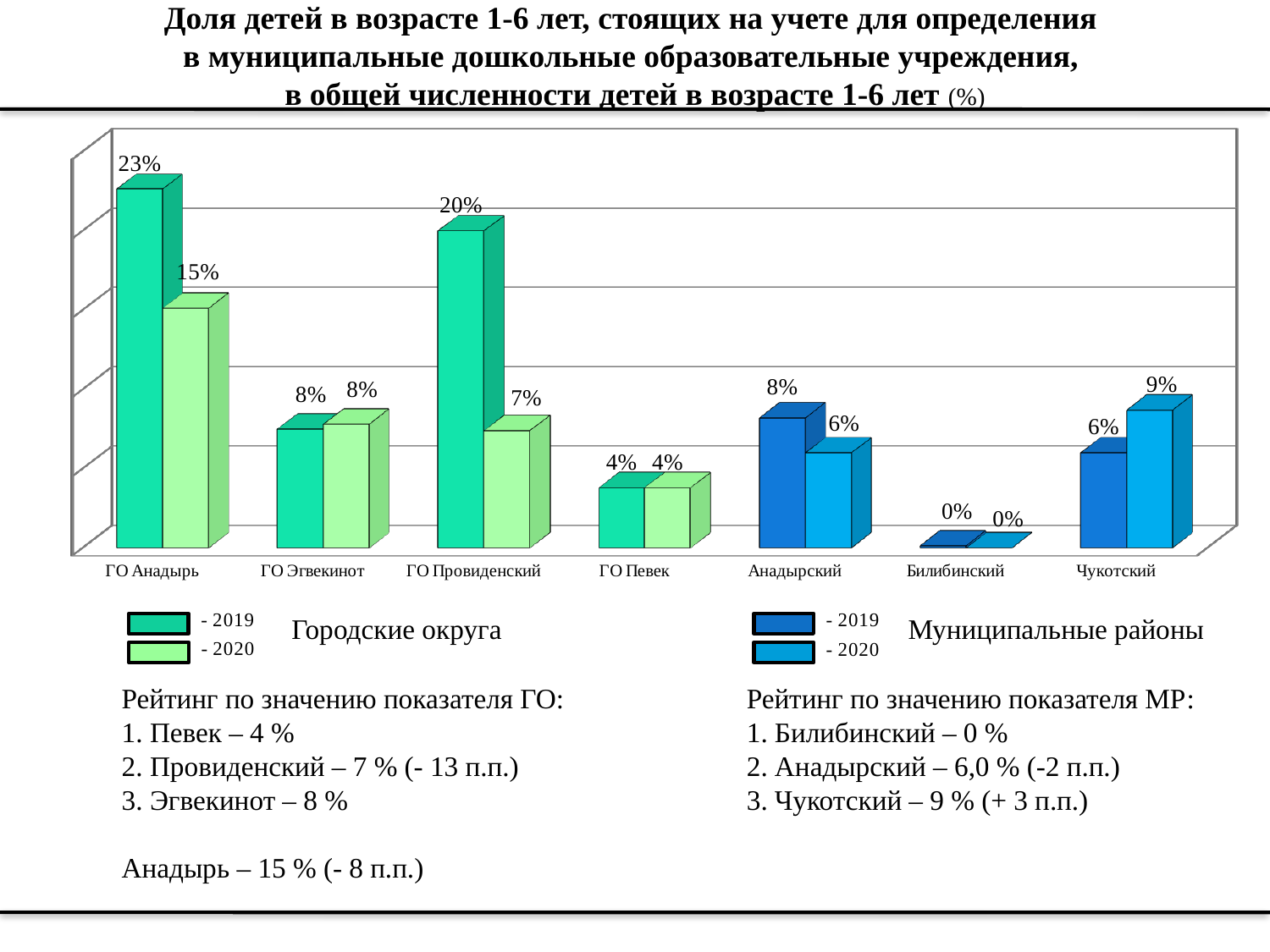
Which category has the lowest 2020 value? Билибинский What is the difference between the 2019 and 2020 values for ГО Анадырь? 8% What is the difference between the 2019 and 2020 values for ГО Провиденский? 13% What is the 2020 value for Чукотский? 9% Which category has the highest 2019 value? ГО Анадырь Did the value for Чукотский rise or fall from 2019 to 2020? rise How many categories are shown on the x axis? 7 What is the 2019 value for ГО Анадырь? 23% Which is larger, the 2020 value for Чукотский or the 2020 value for Анадырский? Чукотский What kind of chart is shown on the slide? bar chart What is the 2020 value for ГО Провиденский? 7% Which two years are compared in the legend? 2019 and 2020